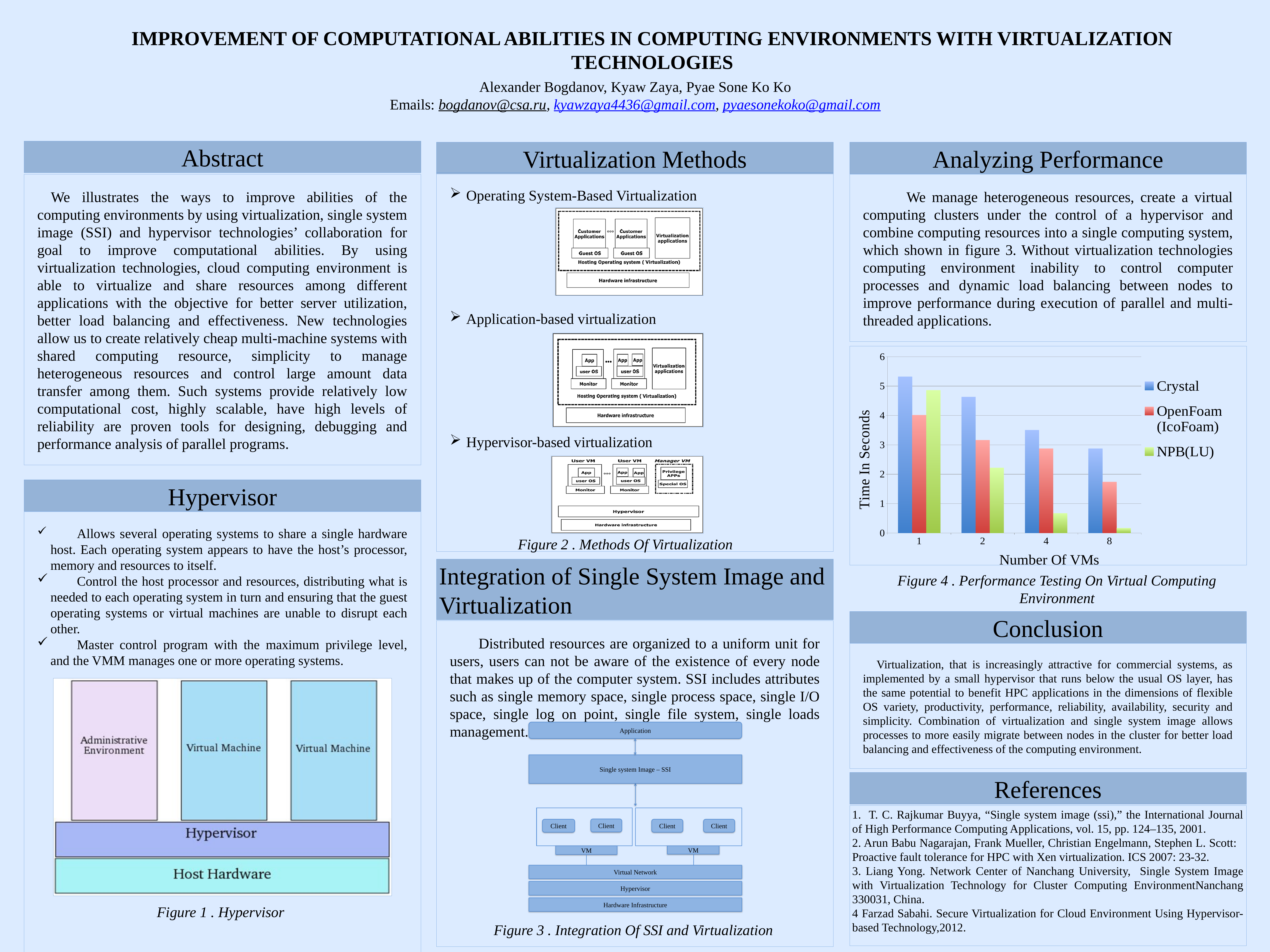
In the Figure 4 chart, which series has the larger value at 2 VMs, Crystal or NPB(LU)? Crystal In the Figure 4 chart, at which number of VMs is the NPB(LU) value lowest? 8 How many series does the legend of the Figure 4 chart list? 3 What is the y-axis title of the Figure 4 chart? Time In Seconds What is the x-axis title of the Figure 4 chart? Number Of VMs In the Figure 4 chart, at which number of VMs is the Crystal value highest? 1 In the Figure 4 chart, is the OpenFoam (IcoFoam) value for 8 VMs greater or less than 2? less In the Figure 4 chart, is the NPB(LU) value for 4 VMs greater or less than 1? less In the Figure 4 chart, do the Crystal values rise or fall as the number of VMs increases? fall How many Number Of VMs categories are plotted on the x axis of the Figure 4 chart? 4 What kind of chart is shown in Figure 4? bar chart In the Figure 4 chart, is the Crystal value for 1 VM greater or less than 5? greater